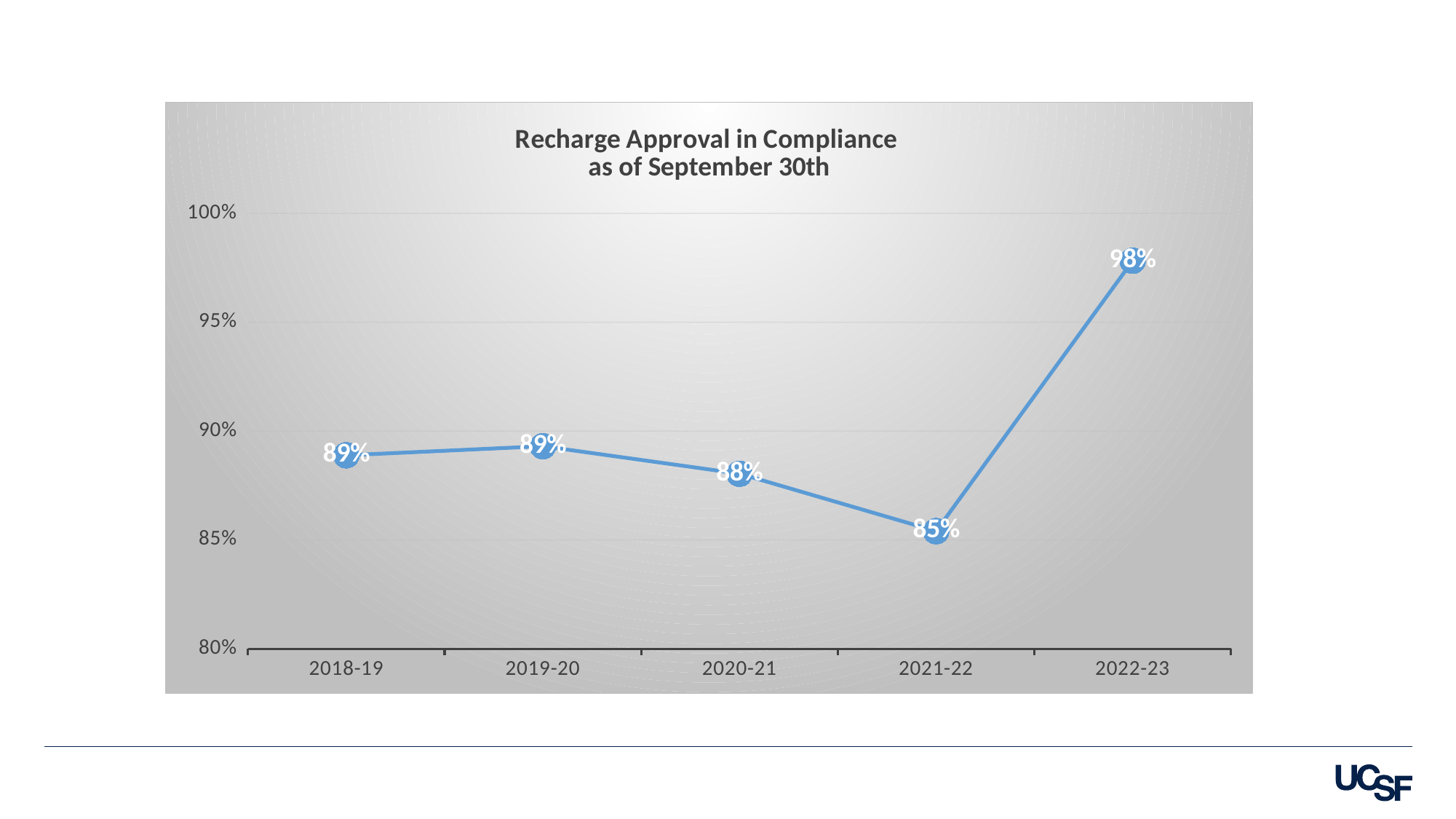
What is the value shown for 2021-22? 85% What is the title of the chart? Recharge Approval in Compliance as of September 30th What is the value shown for 2020-21? 88% What is the recharge approval compliance value for 2022-23? 98% Which year has the highest compliance value? 2022-23 Is the value for 2022-23 greater or less than 95%? greater Which year has the lowest compliance value? 2021-22 Which is larger, the value for 2020-21 or the value for 2021-22? 2020-21 What is the value shown for 2018-19? 89% What is the difference between the 2022-23 value and the 2021-22 value? 13% What kind of chart is shown on the slide? line chart How many years are plotted on the chart? 5